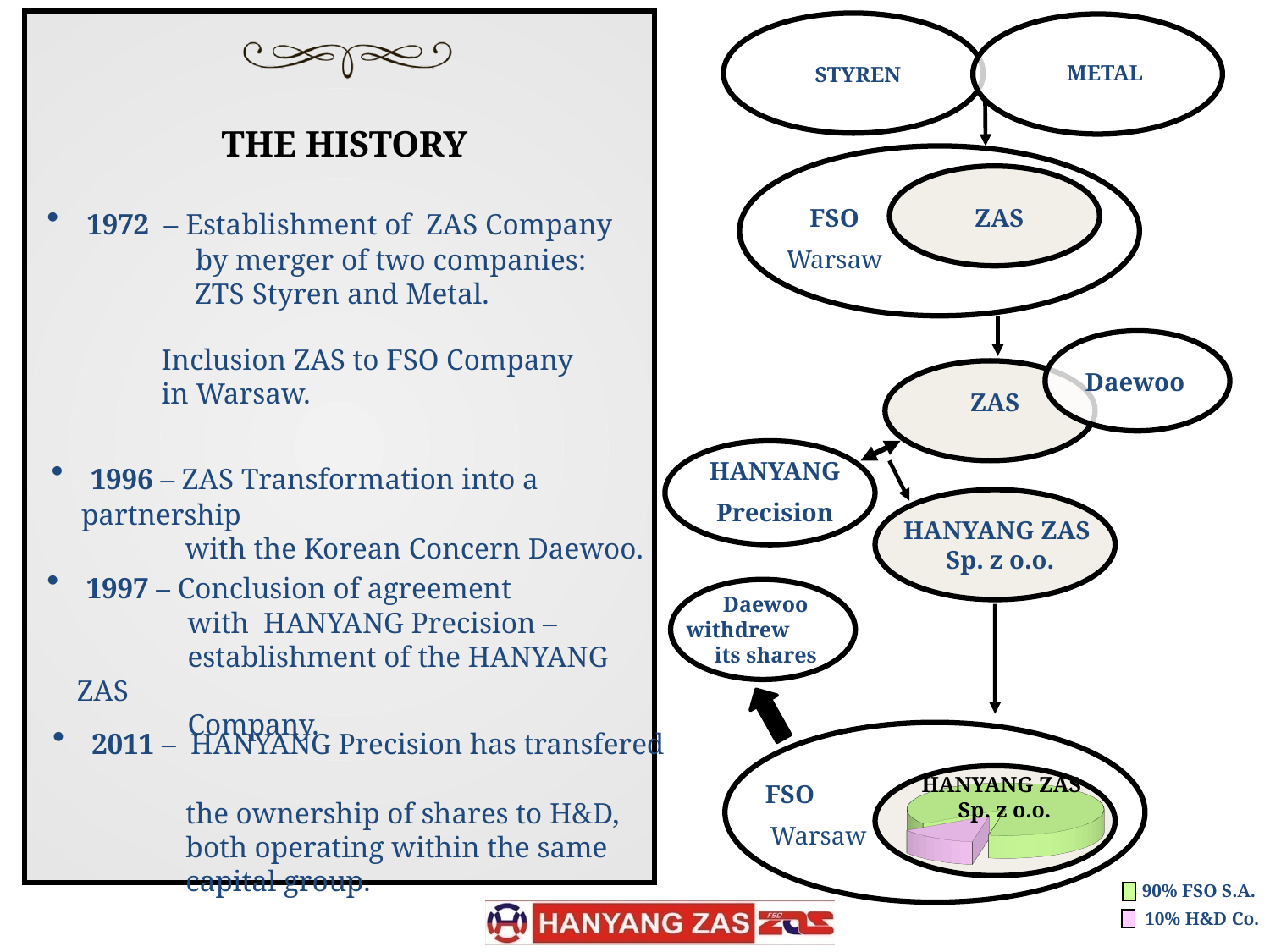
Which slice of the pie chart is the smallest? H&D Co. Which is larger in the pie chart, the share of FSO S.A. or the share of H&D Co.? FSO S.A. Is the share of FSO S.A. in the pie chart greater or less than 50%? greater Which slice of the pie chart is the largest? FSO S.A. What colour represents FSO S.A. in the pie chart legend? green How many slices does the pie chart have? 2 By how many percentage points does the FSO S.A. share exceed the H&D Co. share in the pie chart? 80 percentage points What colour represents H&D Co. in the pie chart legend? pink What kind of chart is shown inside the bottom ellipse on the right side of the slide? pie chart In the pie chart, what share is held by H&D Co.? 10% In the pie chart, what share is held by FSO S.A.? 90% How many entries does the pie chart's legend list? 2